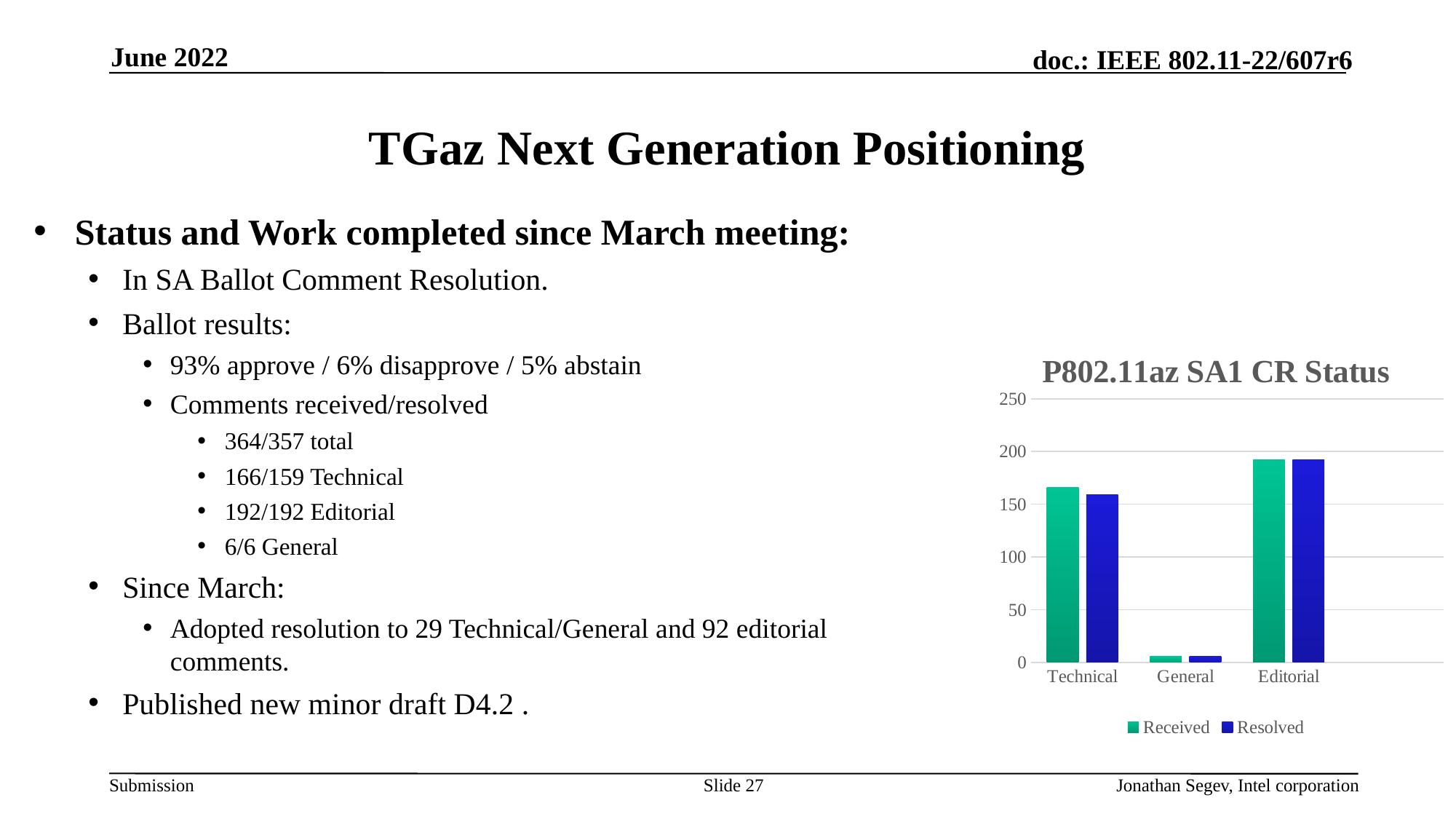
Which category has the highest Received value? Editorial Which category has the lowest Resolved value? General Is the Received value for Editorial greater or less than 200? less Is the Received value for Technical greater or less than 150? greater How many series does the chart legend list? 2 How many categories are shown on the x axis of the chart? 3 What kind of chart is shown on the slide? bar chart Which series is shown in blue in the chart legend? Resolved Is the Resolved value for General greater or less than 50? less What is the title of the chart? P802.11az SA1 CR Status Which is larger, the Resolved value for General or the Resolved value for Technical? Technical Which is larger, the Received value for Technical or the Received value for Editorial? Editorial